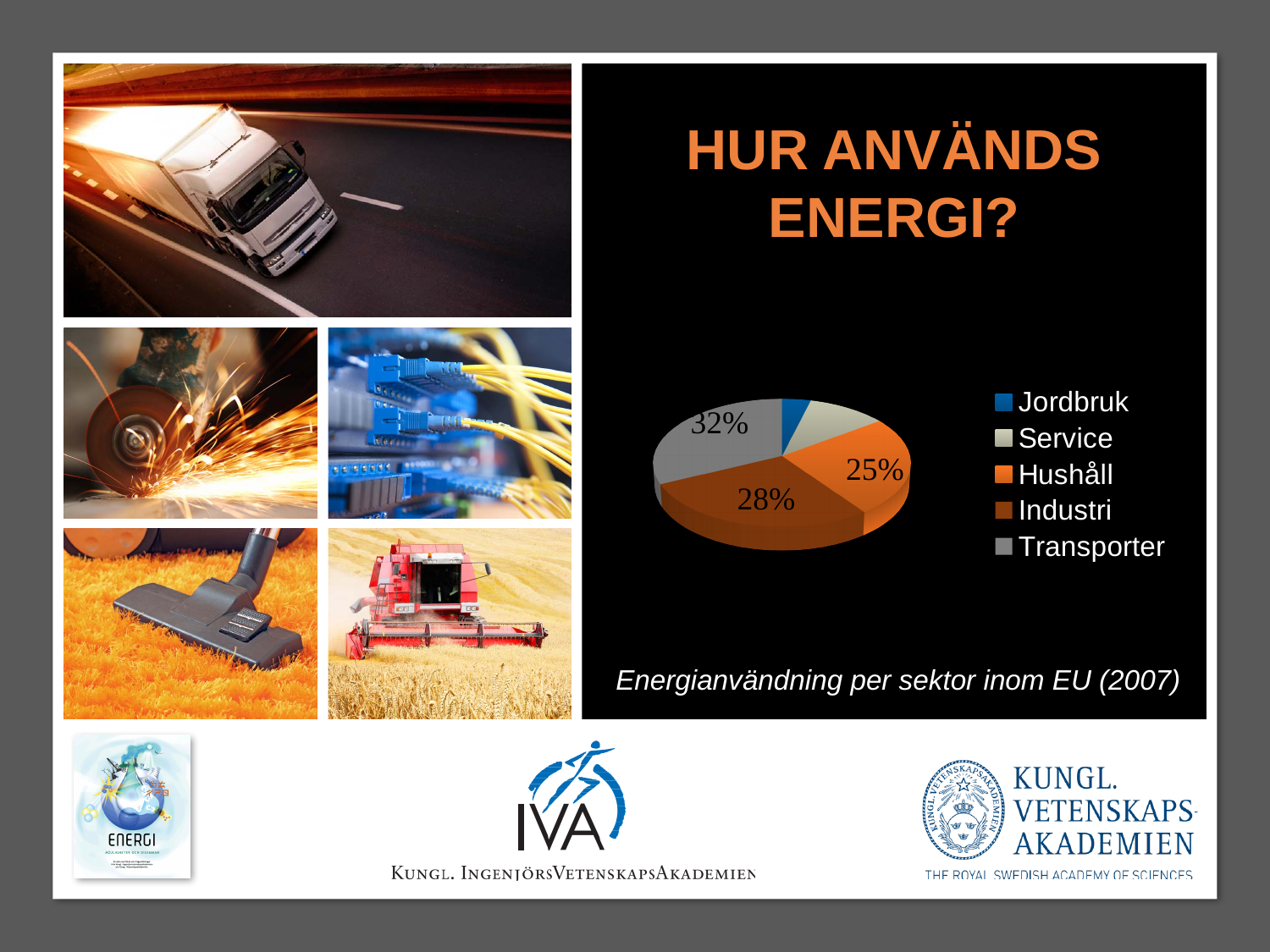
What percentage of the pie chart is Industri? 28% What colour represents Jordbruk in the legend? Blue Which has a larger share, Industri or Hushåll? Industri What is the difference in percentage points between Transporter and Industri? 4 What kind of chart is shown on the slide? Pie chart Which sector has the largest share of the pie chart? Transporter What is the caption below the pie chart? Energianvändning per sektor inom EU (2007) Which sector has the smallest share of the pie chart? Jordbruk What percentage of the pie chart is Transporter? 32% How many sectors are shown in the pie chart? 5 What is the difference in percentage points between Industri and Hushåll? 3 What percentage of the pie chart is Hushåll? 25%